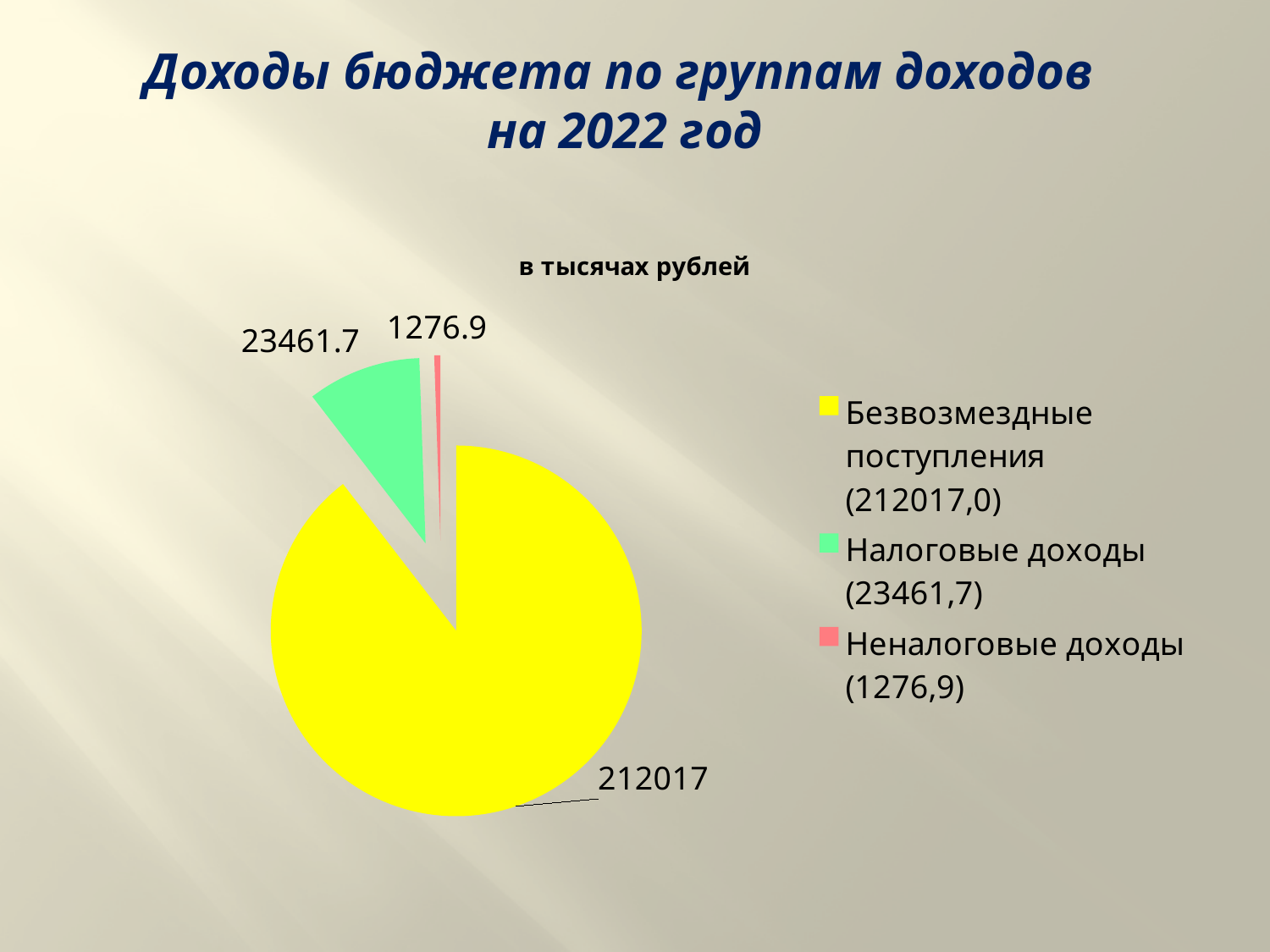
What is the value for Безвозмездные поступления? 212017 What kind of chart is shown on the slide? pie chart How many slices does the pie chart have? 3 What is the difference between Налоговые доходы and Неналоговые доходы? 22184.8 Which is larger, Налоговые доходы or Неналоговые доходы? Налоговые доходы What is the difference between Безвозмездные поступления and Налоговые доходы? 188555.3 What is the total of all three slices of the pie? 236755.6 What is the value for Неналоговые доходы? 1276.9 What is the value for Налоговые доходы? 23461.7 What unit is stated in the chart title? в тысячах рублей Which category has the largest slice of the pie? Безвозмездные поступления Which category has the smallest slice of the pie? Неналоговые доходы